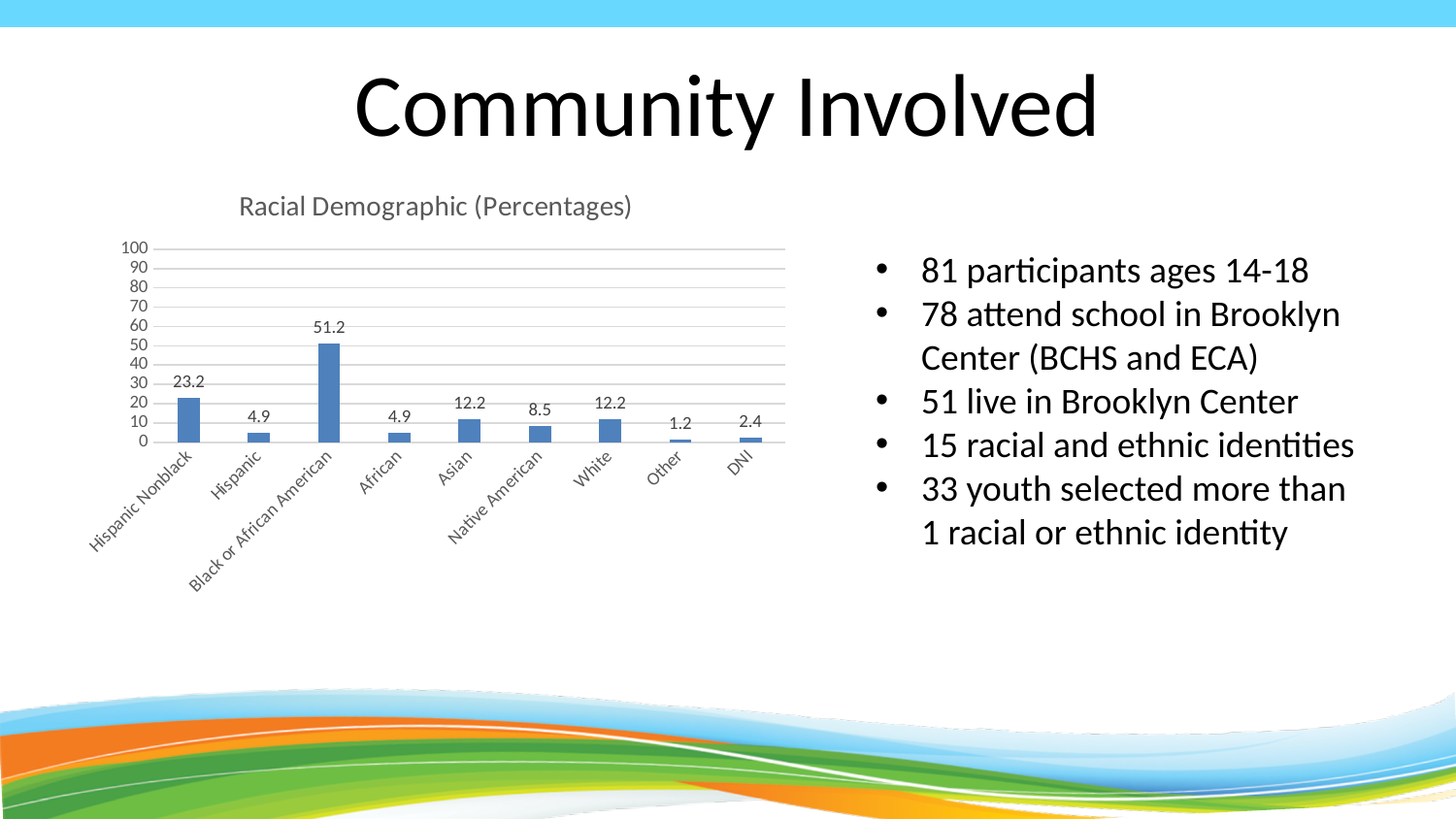
Which is larger, the value for Native American or the value for White? White What is the value for Black or African American in the Racial Demographic (Percentages) chart? 51.2 What is the value for DNI? 2.4 What kind of chart is shown on the slide? bar chart What is the title of the chart? Racial Demographic (Percentages) How many categories are shown on the x axis? 9 Is the value for Black or African American greater or less than 50? greater Which category has the lowest value? Other Which category has the highest value? Black or African American What is the difference between the values for Black or African American and Hispanic Nonblack? 28 What is the value for Native American? 8.5 What is the value for Hispanic Nonblack? 23.2